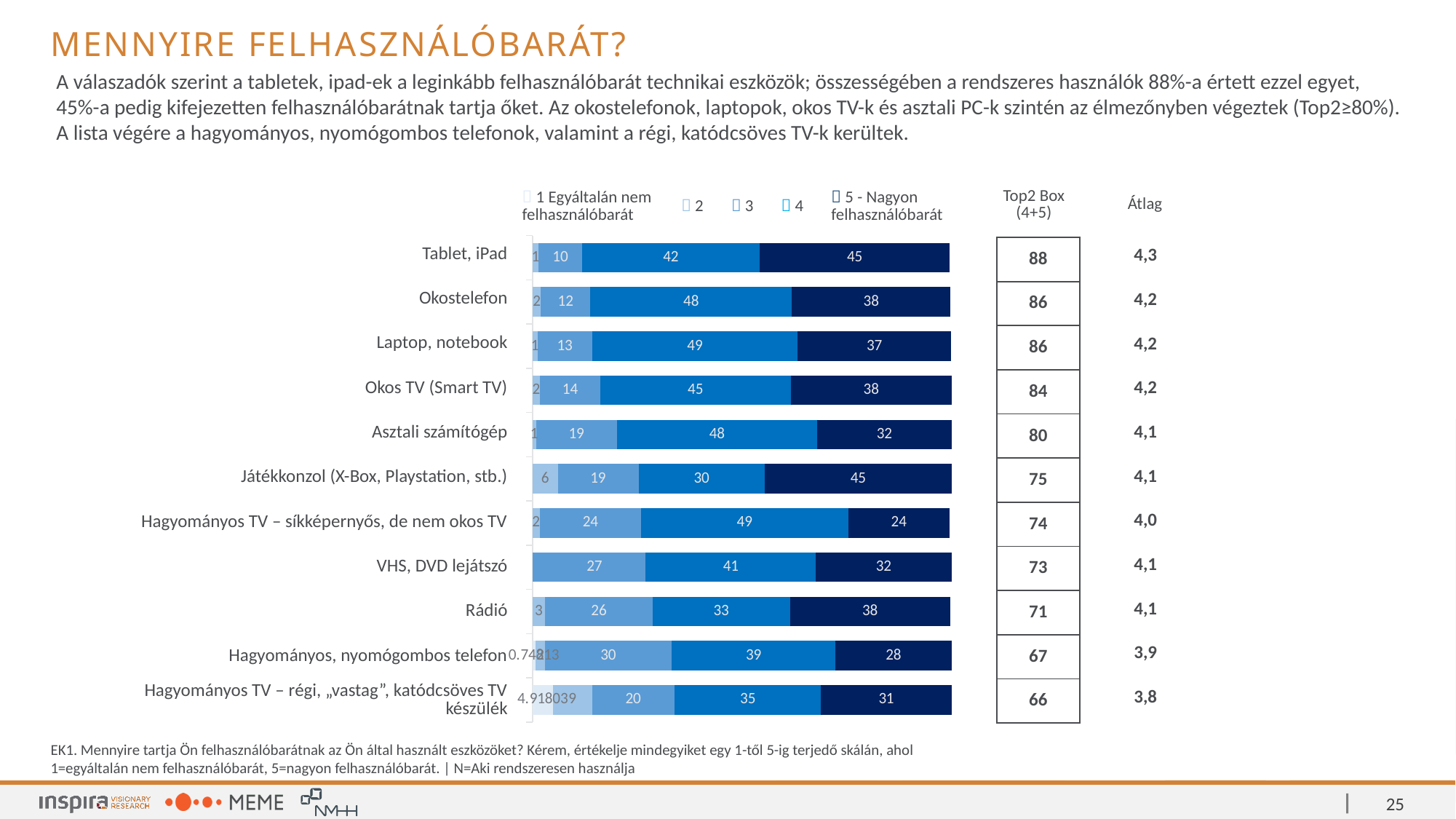
How many device categories are plotted in the chart? 11 What is the Top2 Box (4+5) value shown for Asztali számítógép? 80 What is the "5 - Nagyon felhasználóbarát" value for Hagyományos TV – síkképernyős, de nem okos TV? 24 How many series does the chart legend list? 5 What is the Átlag value shown for Tablet, iPad? 4,3 How much higher is the "5 - Nagyon felhasználóbarát" value for Tablet, iPad than for Okostelefon? 7 What is the "5 - Nagyon felhasználóbarát" value for Tablet, iPad? 45 Which category has the lowest "5 - Nagyon felhasználóbarát" value? Hagyományos TV – síkképernyős, de nem okos TV Which has the larger "5 - Nagyon felhasználóbarát" value, Rádió or VHS, DVD lejátszó? Rádió What is the value of the "4" segment for Okostelefon? 48 What kind of chart is shown on the slide? stacked bar chart Which category has the lowest value in the "4" series? Játékkonzol (X-Box, Playstation, stb.)